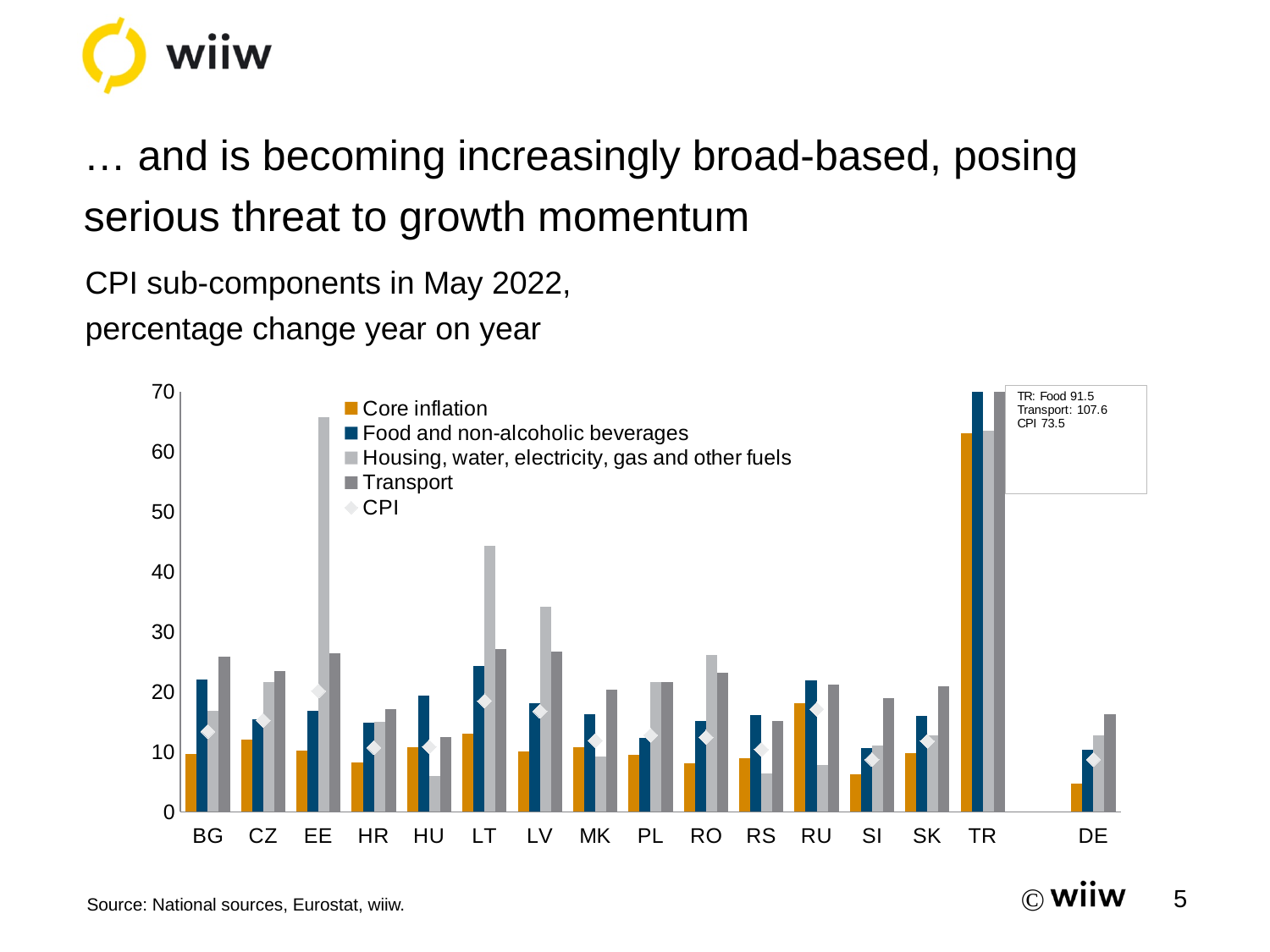
For BG, which is larger: the Transport value or the Core inflation value? Transport How many series does the chart's legend list? 5 What is the difference between the Transport value and the Food and non-alcoholic beverages value for TR? 16.1 Is the Core inflation value for DE greater or less than 10? less Which series in the legend is plotted as diamond markers rather than bars? CPI According to the annotation on the chart, what is the CPI value for TR? 73.5 Which country has the highest Transport value in the chart? TR Is the Housing, water, electricity, gas and other fuels value for EE greater or less than 60? greater According to the annotation on the chart, what is the Food and non-alcoholic beverages value for TR? 91.5 How many countries are shown on the x axis of the chart? 16 According to the annotation on the chart, what is the Transport value for TR? 107.6 What kind of chart is shown on the slide? bar chart